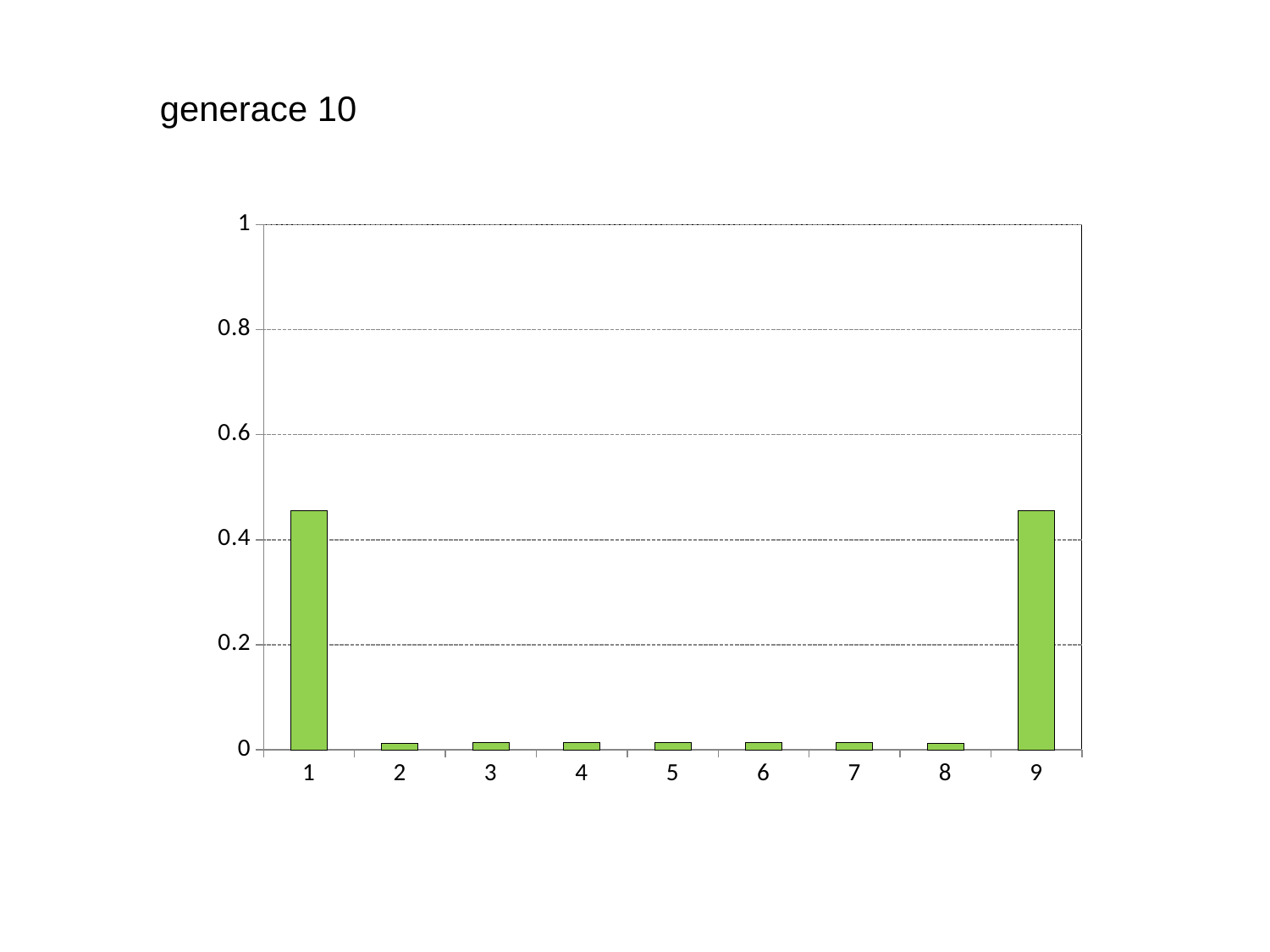
Which has the larger value, category 1 or category 2? category 1 Is the value for category 1 greater or less than 0.6? less What colour are the bars in the chart? green How many categories are shown on the x axis of the chart? 9 Is the value for category 1 greater or less than 0.4? greater Is the value for category 3 greater or less than 0.2? less What kind of chart is shown on the slide? bar chart Which has the larger value, category 5 or category 9? category 9 What is the highest value shown on the y axis of the chart? 1 Which has the larger value, category 8 or category 9? category 9